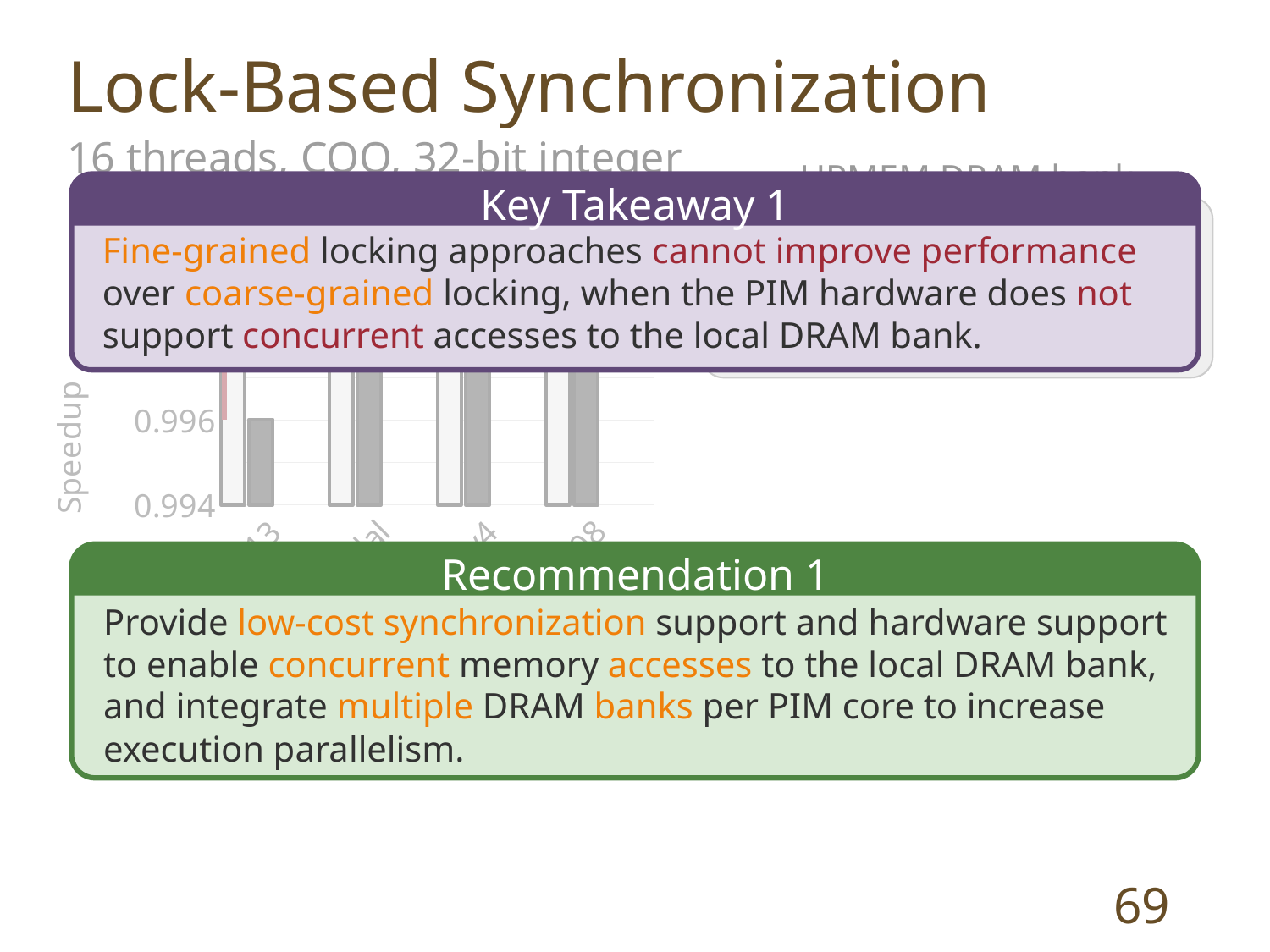
What is the lowest tick value shown on the vertical axis of the chart? 0.994 What is the label on the vertical axis of the chart? Speedup What kind of chart is shown on the slide? bar chart Is the value of the leftmost bar in the chart greater or less than 0.996? greater